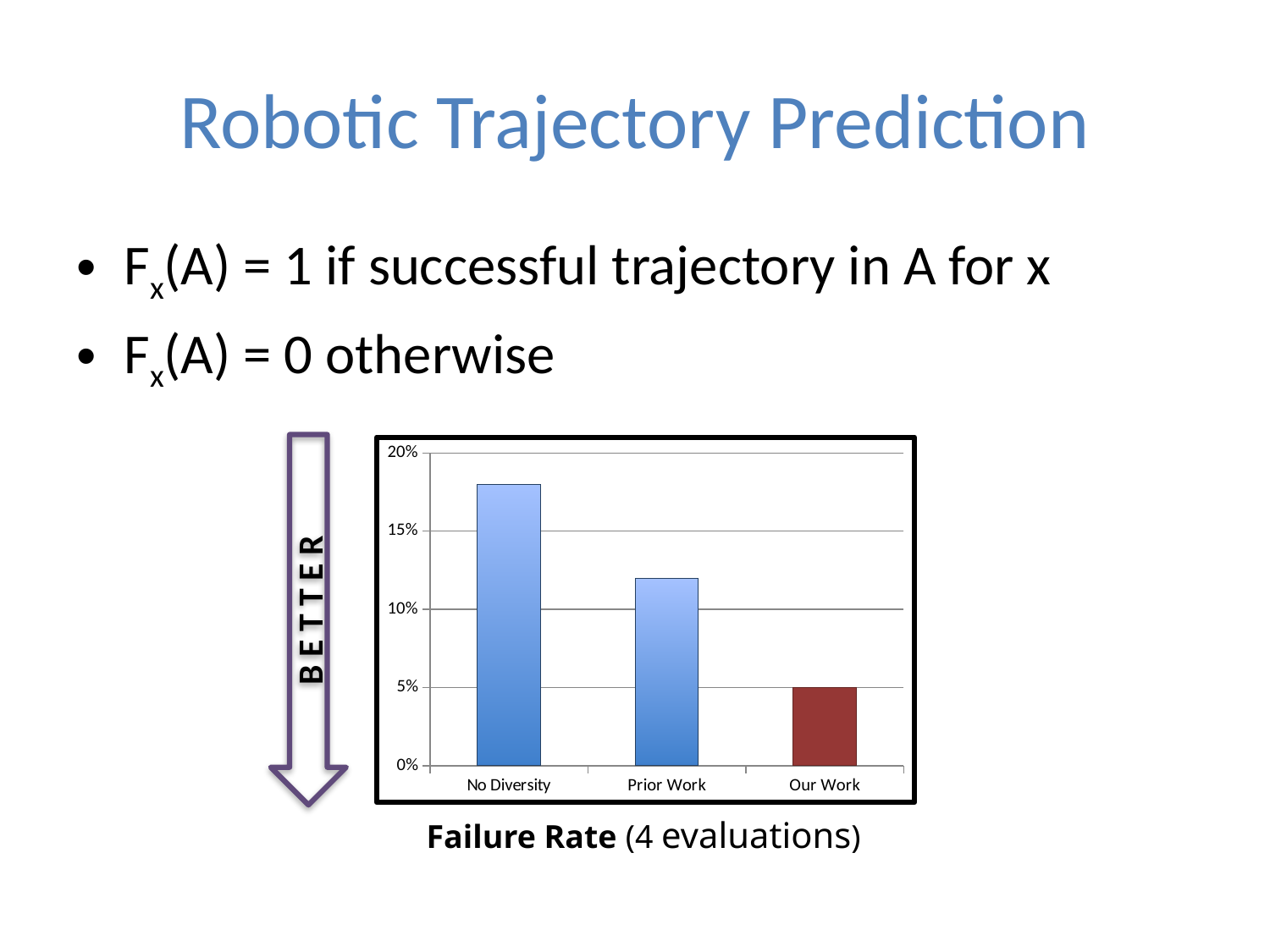
Do the bar values rise or fall from left to right along the x axis? fall Is the value for Prior Work greater or less than 10%? greater Which category has the lowest failure rate in the chart? Our Work Which category's bar is drawn in a different colour (red) from the others? Our Work Is the value for Prior Work greater or less than 15%? less What is the failure rate for Our Work? 5% Which has a higher failure rate, No Diversity or Prior Work? No Diversity How many categories are plotted on the x axis of the chart? 3 Is the value for No Diversity greater or less than 15%? greater Which category has the highest failure rate in the chart? No Diversity What kind of chart is shown on the slide? bar chart